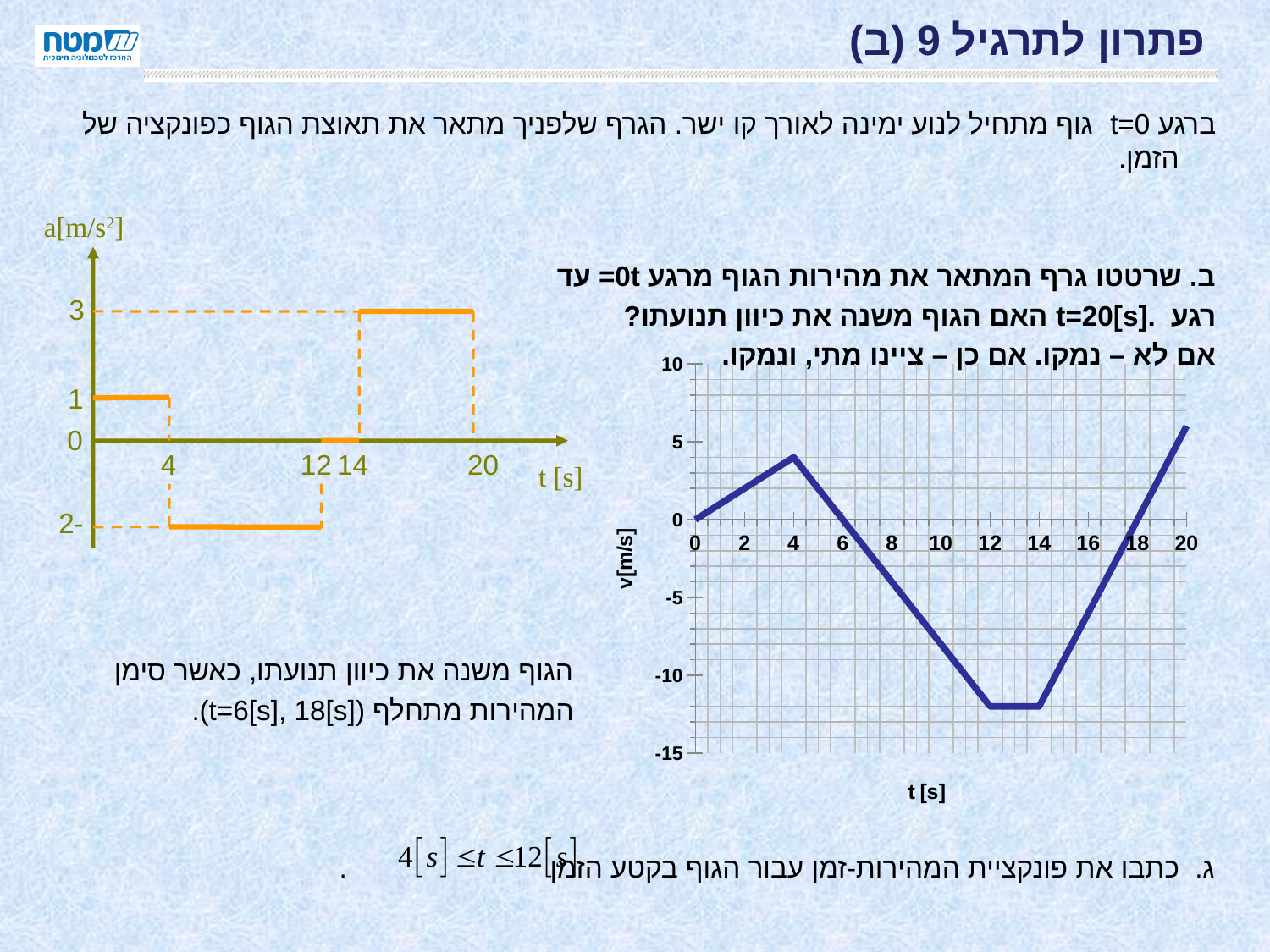
On the acceleration-time graph (left chart), what is the difference between the highest acceleration value and the lowest acceleration value? 5 On the velocity-time graph (right chart), what is the velocity at t=0? 0 On the velocity-time graph (right chart), is the velocity at t=12 greater or less than -10? less On the acceleration-time graph (left chart), in which time interval is the acceleration highest? 14 to 20 On the velocity-time graph (right chart), does the velocity rise or fall between t=4 and t=12? fall On the velocity-time graph (right chart), what is the label of the vertical axis? v[m/s] On the acceleration-time graph (left chart), in which time interval is the acceleration lowest? 4 to 12 On the acceleration-time graph (left chart), what is the acceleration value between t=4 and t=12? -2 What kind of chart is the velocity-time graph on the right? line chart On the velocity-time graph (right chart), is the velocity at t=4 greater or less than 0? greater On the acceleration-time graph (left chart), what is the acceleration value between t=14 and t=20? 3 On the acceleration-time graph (left chart), what is the acceleration value between t=0 and t=4? 1